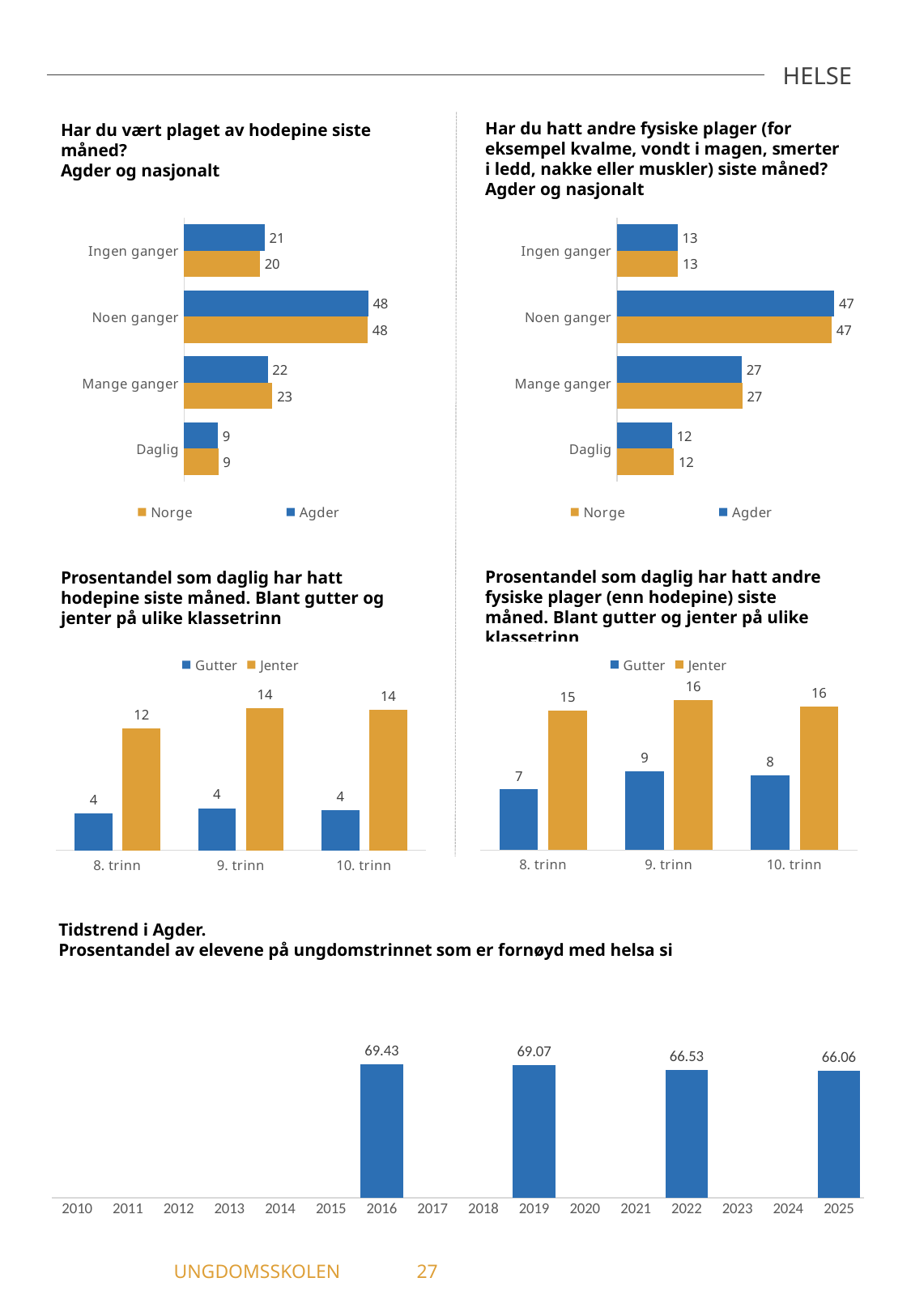
In the chart 'Tidstrend i Agder', do the values rise or fall from 2016 to 2025? fall In the chart 'Har du hatt andre fysiske plager ... siste måned? Agder og nasjonalt', what is the value for Norge for 'Mange ganger'? 27 In the chart 'Prosentandel som daglig har hatt andre fysiske plager (enn hodepine) siste måned', which klassetrinn has the highest value for Gutter? 9. trinn How many series does the legend list in the chart 'Har du hatt andre fysiske plager ... siste måned? Agder og nasjonalt'? 2 In the chart 'Prosentandel som daglig har hatt hodepine siste måned. Blant gutter og jenter på ulike klassetrinn', what is the value for Jenter in 9. trinn? 14 In the chart 'Prosentandel som daglig har hatt hodepine siste måned. Blant gutter og jenter på ulike klassetrinn', what is the difference between Jenter and Gutter in 8. trinn? 8 In the chart 'Prosentandel som daglig har hatt andre fysiske plager (enn hodepine) siste måned', which is larger in 10. trinn: Gutter or Jenter? Jenter In the chart 'Tidstrend i Agder', what is the value for 2022? 66.53 In the chart 'Har du vært plaget av hodepine siste måned? Agder og nasjonalt', what is the difference between the Norge value for 'Mange ganger' and the Norge value for 'Daglig'? 14 In the chart 'Har du hatt andre fysiske plager ... siste måned? Agder og nasjonalt', which category has the lowest value for Agder? Daglig In the chart 'Har du vært plaget av hodepine siste måned? Agder og nasjonalt', which category has the highest value for Norge? Noen ganger In the chart 'Har du vært plaget av hodepine siste måned? Agder og nasjonalt', what is the value for Agder for 'Ingen ganger'? 21